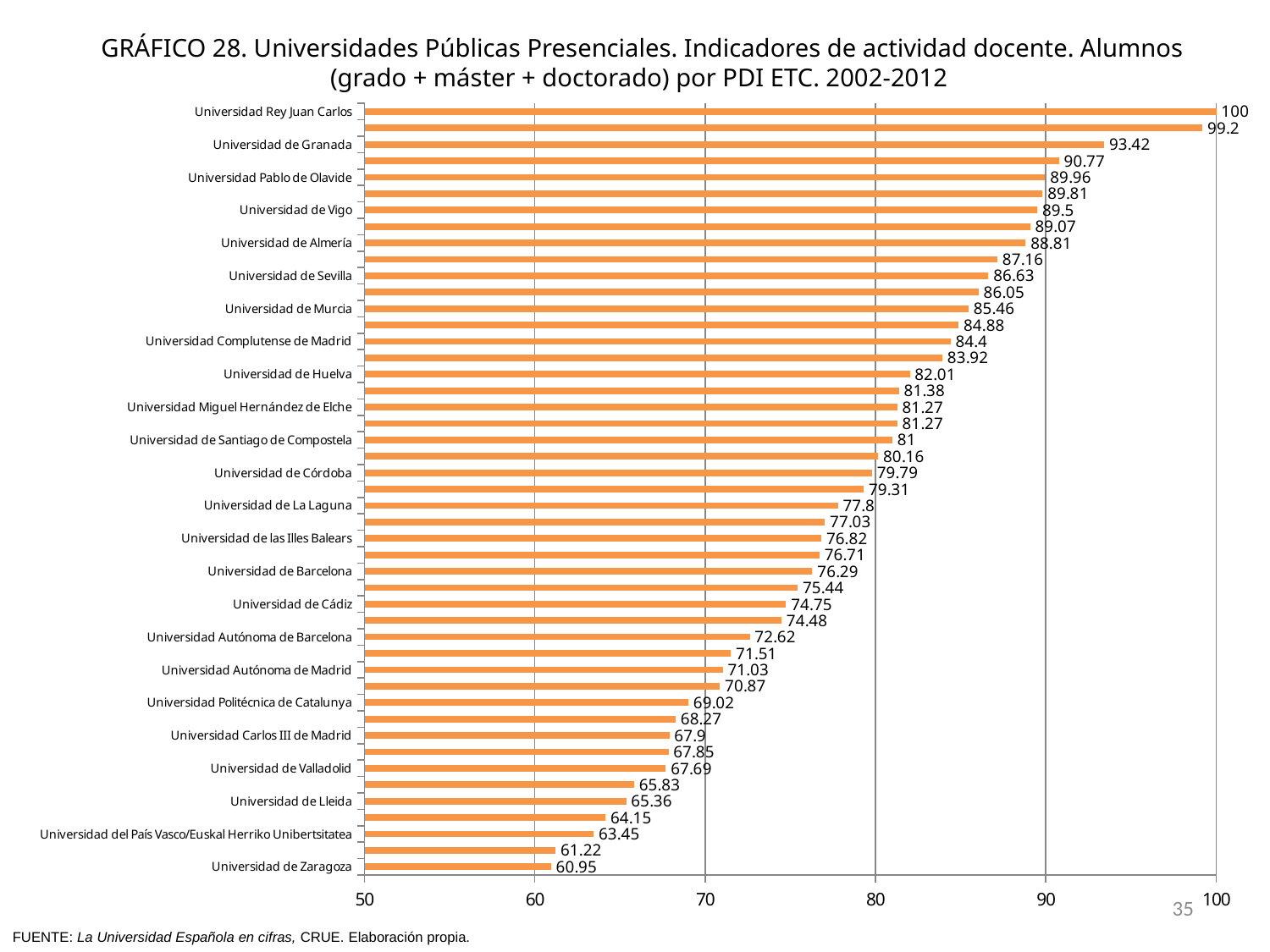
Which university has the highest value? Universidad Rey Juan Carlos Which university has the lowest value? Universidad de Zaragoza What is the value for Universidad de Santiago de Compostela? 81 What is the value for Universidad de Granada? 93.42 Which has a larger value, Universidad de Sevilla or Universidad de Cádiz? Universidad de Sevilla What is the value for Universidad Complutense de Madrid? 84.4 Do the values rise or fall going down the list of universities from top to bottom? fall What type of chart is shown on the slide? bar chart Is the value for Universidad de Lleida greater or less than 70? less What is the difference between the values for Universidad Rey Juan Carlos and Universidad de Zaragoza? 39.05 What is the value for Universidad de Zaragoza? 60.95 What is the value for Universidad Rey Juan Carlos? 100